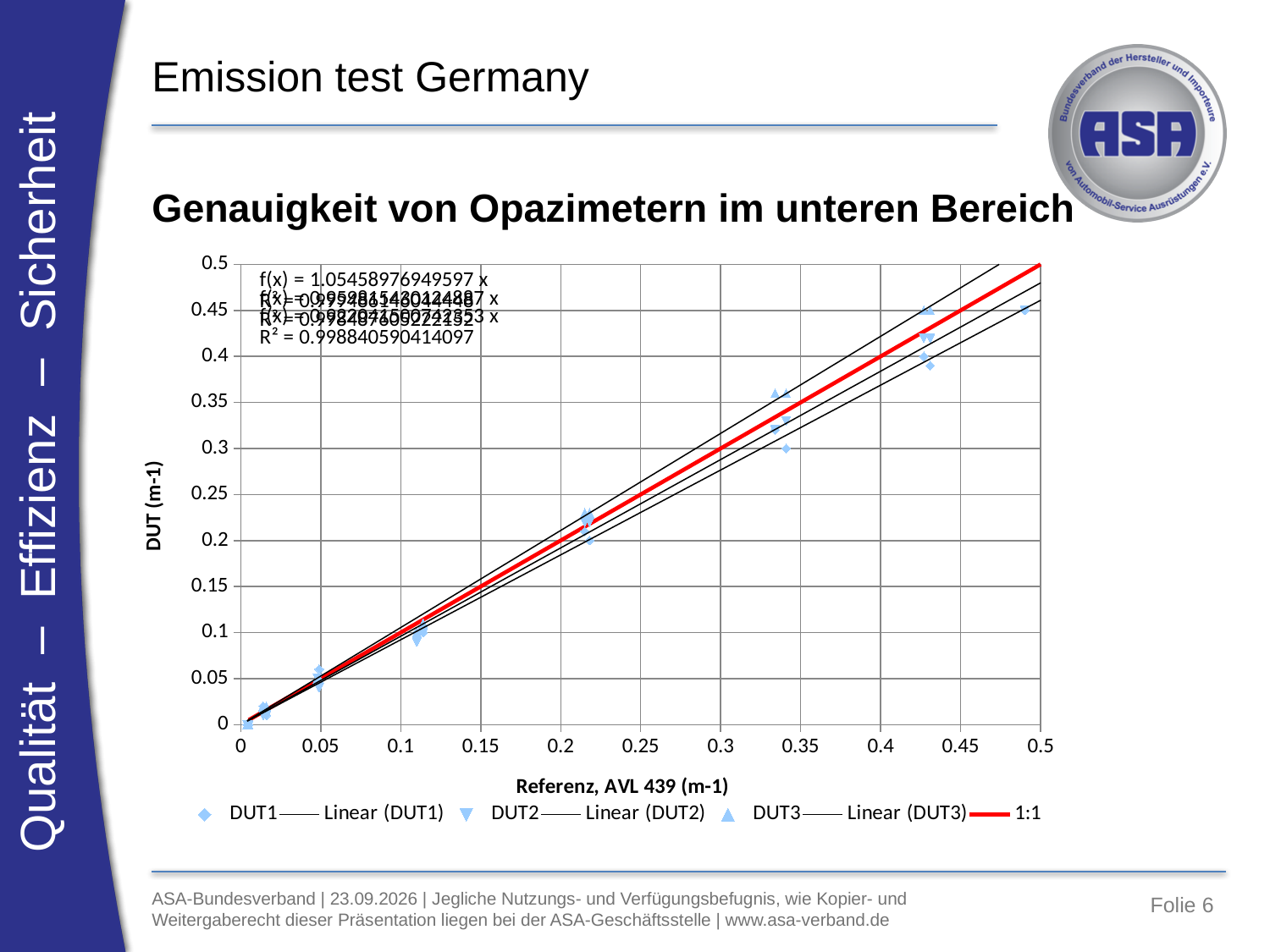
Are the DUT values plotted at a reference value of about 0.34 greater or less than 0.4? less How many DUT data series (excluding trendlines and the 1:1 line) are plotted in the chart? 3 Are the DUT values plotted at the highest reference value (near 0.49) greater or less than 0.4? greater Do the DUT values rise or fall as the reference value increases along the x axis? rise What is the title of the x axis of the chart? Referenz, AVL 439 (m-1) What kind of chart is shown on the slide? scatter chart How many entries does the chart legend list? 7 Are the DUT values plotted at a reference value of about 0.22 greater or less than 0.3? less What is the maximum value shown on the y axis of the chart? 0.5 What is the title of the y axis of the chart? DUT (m-1) What DUT value does the red 1:1 line reach at a reference value of 0.5? 0.5